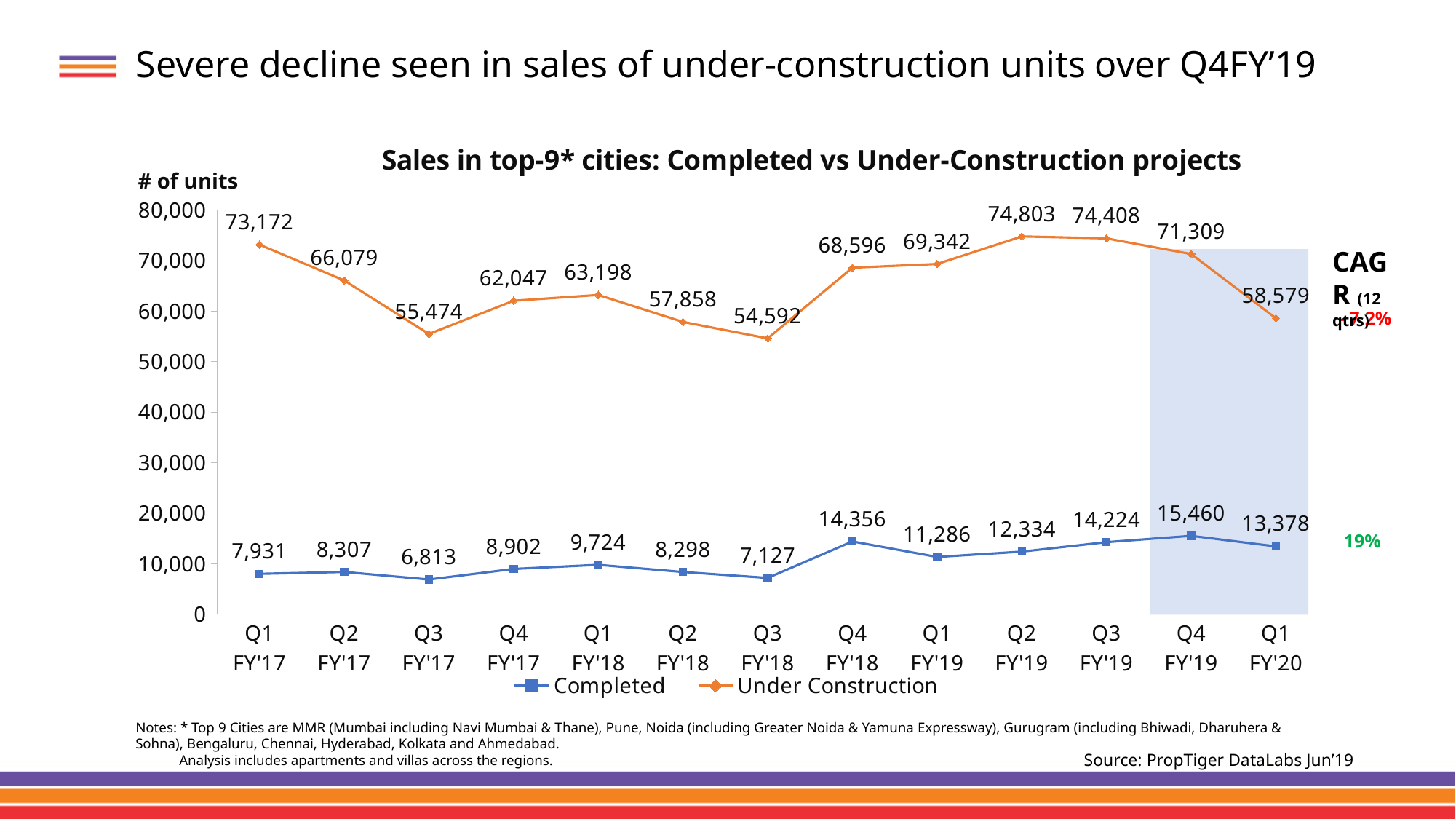
How many series does the legend list? 2 What is the difference between the Under Construction values for Q4 FY'19 and Q1 FY'20? 12,730 Which is larger: the Completed value for Q4 FY'19 or for Q1 FY'20? Q4 FY'19 Is the Under Construction value for Q3 FY'18 greater or less than 60,000? less What is the title of the chart? Sales in top-9* cities: Completed vs Under-Construction projects How many quarters are plotted along the x axis? 13 What is the Completed sales value for Q4 FY'18? 14,356 In which quarter is the Under Construction value highest? Q2 FY'19 What is the Under Construction sales value for Q1 FY'20? 58,579 What type of chart is shown on the slide? Line chart Does the Under Construction series rise or fall from Q4 FY'19 to Q1 FY'20? Fall In which quarter is the Completed value lowest? Q3 FY'17